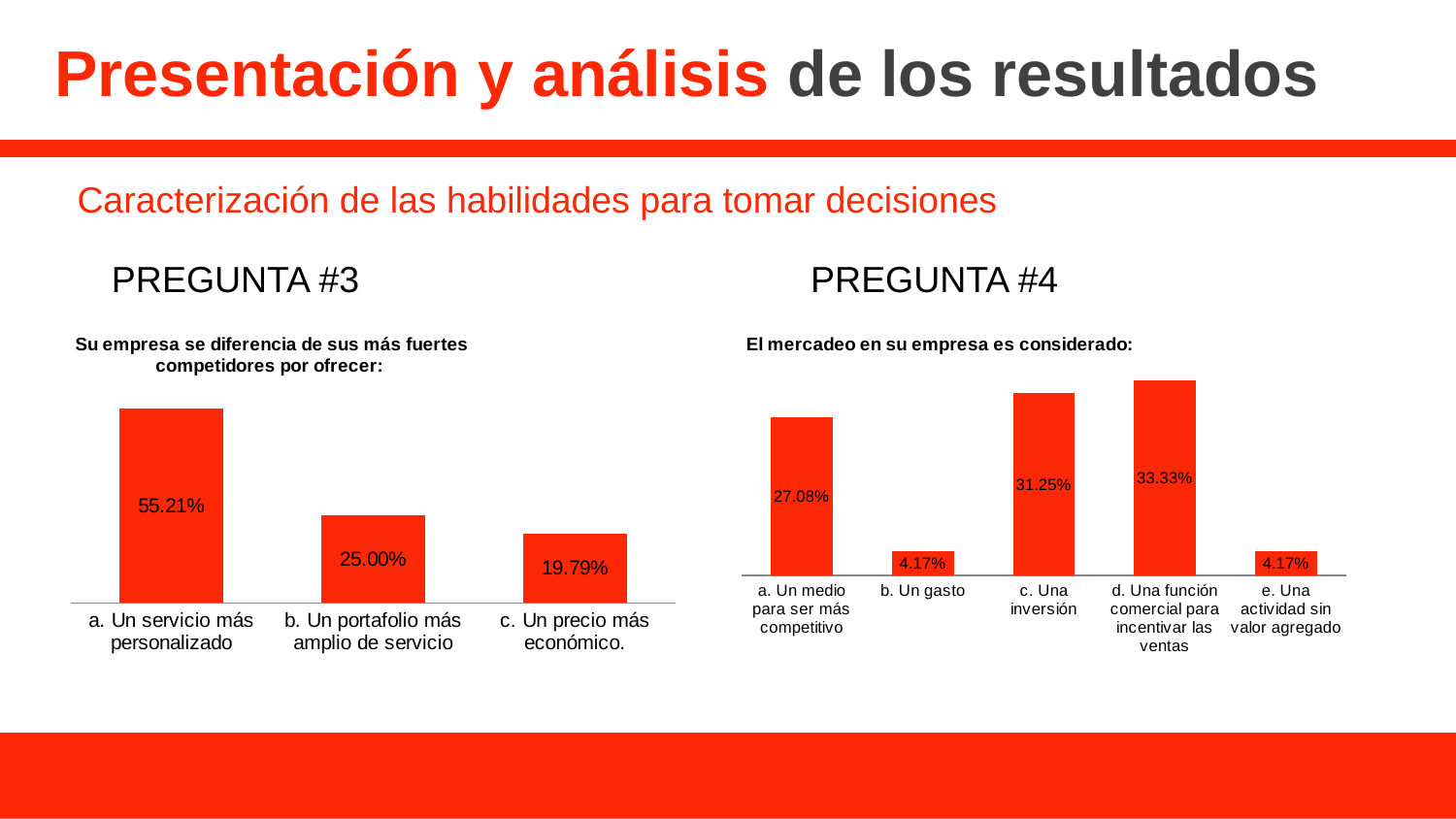
In the left chart (PREGUNTA #3), what is the difference between 'a. Un servicio más personalizado' and 'b. Un portafolio más amplio de servicio'? 30.21% In the right chart (PREGUNTA #4), which is larger: 'a. Un medio para ser más competitivo' or 'c. Una inversión'? c. Una inversión In the right chart (PREGUNTA #4), what is the difference between 'd. Una función comercial para incentivar las ventas' and 'a. Un medio para ser más competitivo'? 6.25% In the left chart (PREGUNTA #3), what is the value for 'c. Un precio más económico.'? 19.79% In the right chart (PREGUNTA #4), what is the value for 'b. Un gasto'? 4.17% In the right chart (PREGUNTA #4), what is the value for 'c. Una inversión'? 31.25% In the left chart (PREGUNTA #3), which category has the lowest value? c. Un precio más económico. What type of chart is used for PREGUNTA #4 on the right? Bar chart In the right chart (PREGUNTA #4), which category has the highest value? d. Una función comercial para incentivar las ventas In the left chart (PREGUNTA #3), how many categories are shown? 3 In the right chart (PREGUNTA #4), how many categories are shown? 5 In the left chart (PREGUNTA #3), what is the value for 'a. Un servicio más personalizado'? 55.21%